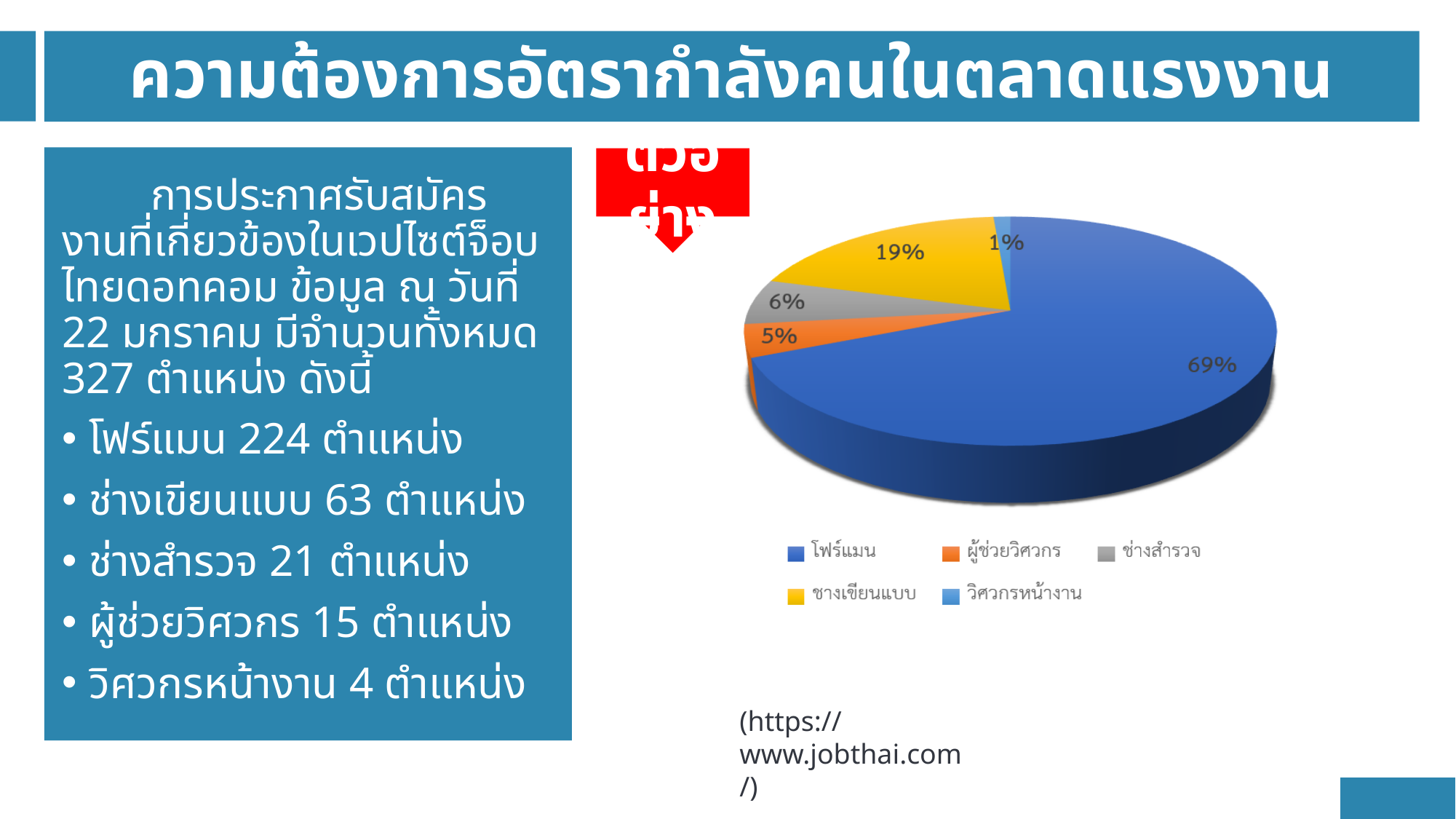
Which category has the largest share of the pie chart? โฟร์แมน Which category has the smallest share of the pie chart? วิศวกรหน้างาน What percentage of the pie chart is ช่างสำรวจ? 6% What percentage of the pie chart is ช่างเขียนแบบ? 19% What percentage of the pie chart is วิศวกรหน้างาน? 1% What is the difference in percentage points between โฟร์แมน and ช่างเขียนแบบ? 50 Which has a larger share of the pie chart, ช่างสำรวจ or ผู้ช่วยวิศวกร? ช่างสำรวจ What percentage of the pie chart is ผู้ช่วยวิศวกร? 5% What colour is the slice for ช่างเขียนแบบ in the pie chart? Yellow How many categories does the pie chart legend list? 5 What percentage of the pie chart is โฟร์แมน? 69% What type of chart is shown on the slide? Pie chart